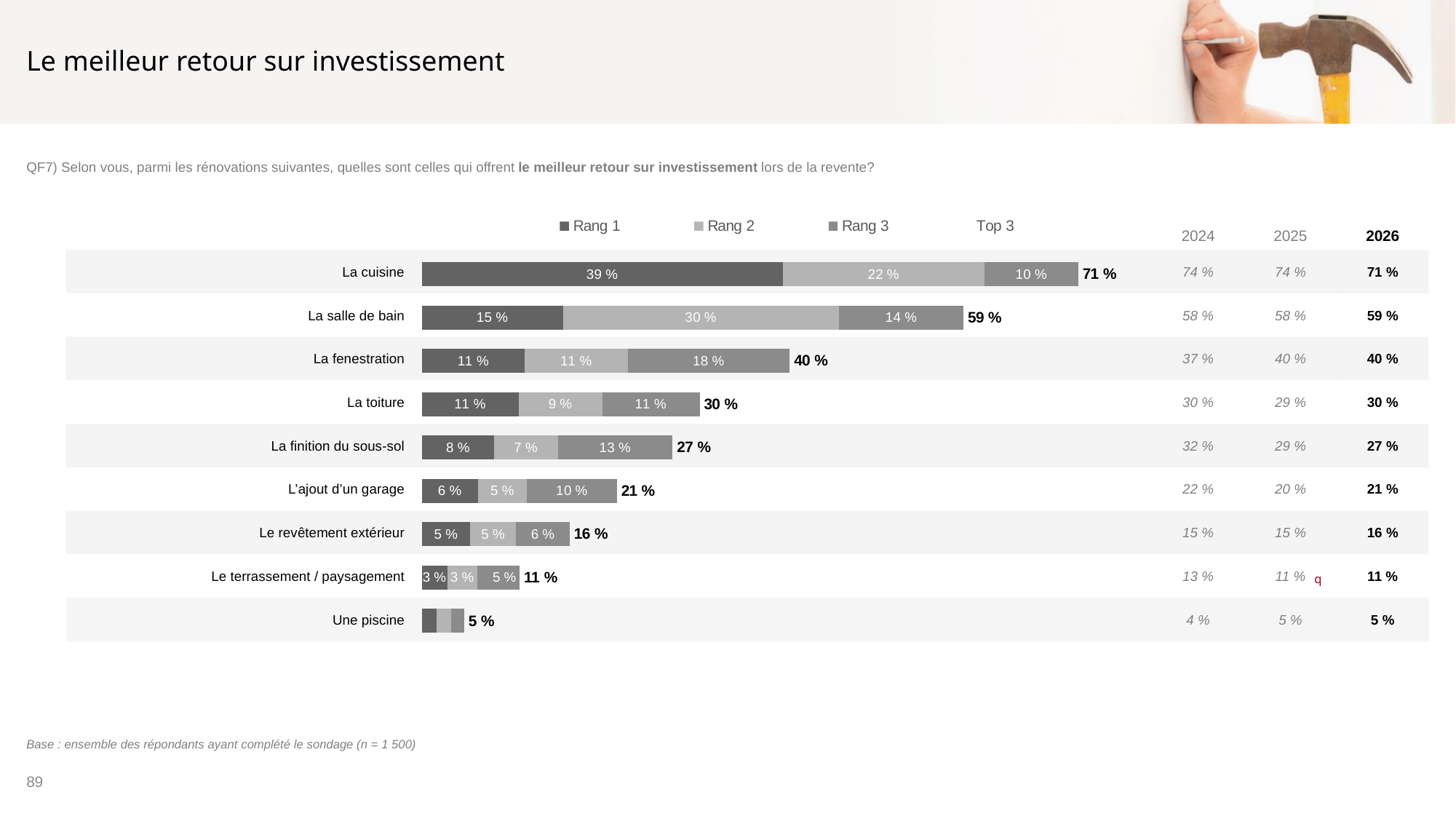
Which renovation has the lowest Top 3 value? Une piscine What kind of chart is shown on the slide? Stacked bar chart What is the Top 3 value for La fenestration? 40 % What is the Rang 2 value for La salle de bain? 30 % How many Rang series does the legend list? 3 What is the Rang 1 value for La cuisine? 39 % How many renovation categories are shown in the chart? 9 What was the 2024 value for La cuisine in the table on the right? 74 % Which has the larger Rang 3 value, La fenestration or La salle de bain? La fenestration What is the Rang 3 value for La finition du sous-sol? 13 % What is the difference between the Top 3 values for La cuisine and La salle de bain? 12 % Which renovation has the highest Top 3 value? La cuisine